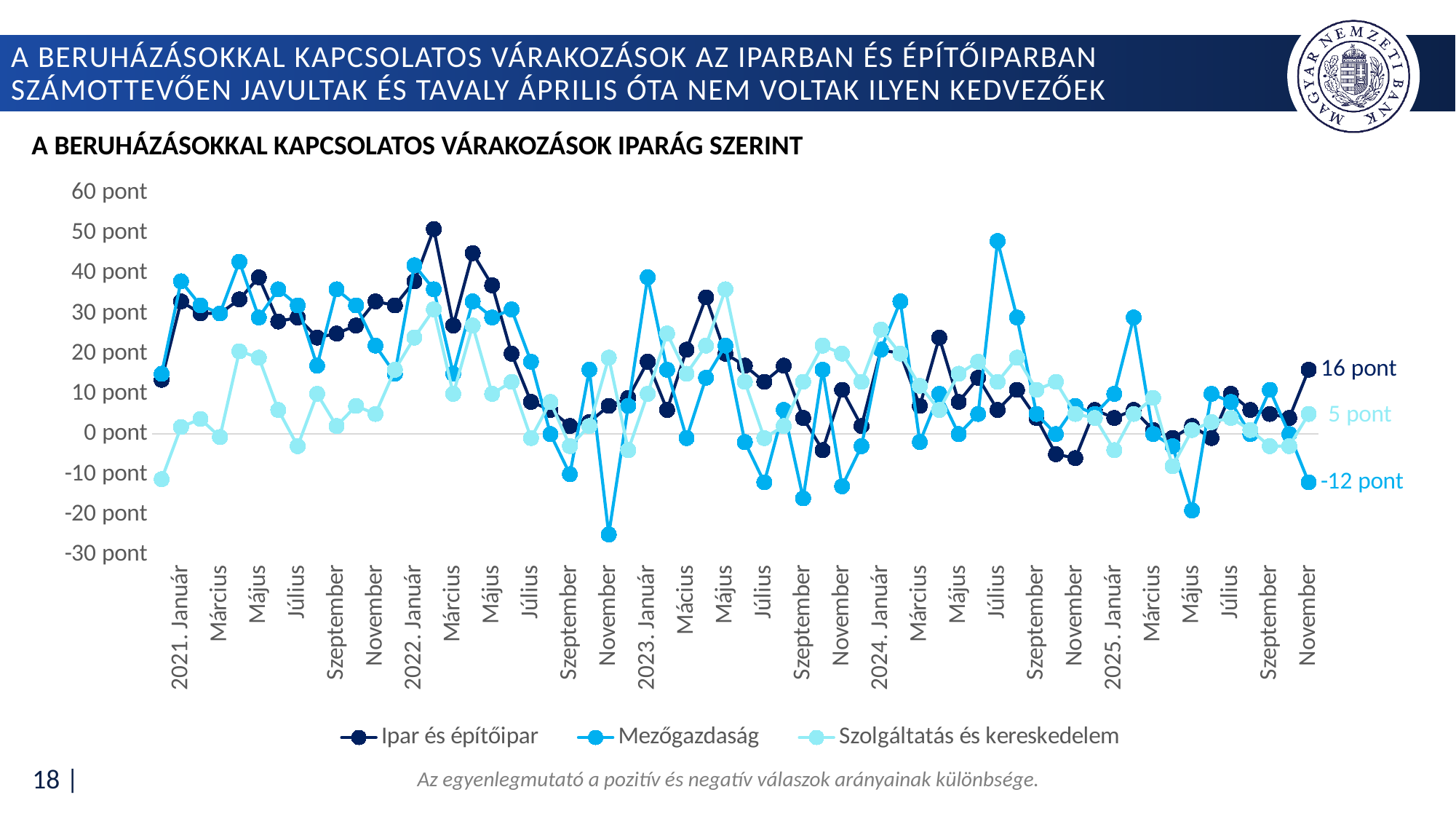
What kind of chart is shown on the slide? Line chart What is the final (November 2025) value shown for the Ipar és építőipar series? 16 pont Which series has the lowest value at the last data point (November 2025)? Mezőgazdaság What is the difference between the final values of Ipar és építőipar and Mezőgazdaság? 28 pont What is the difference between the final values of Ipar és építőipar and Szolgáltatás és kereskedelem? 11 pont What is the final (November 2025) value shown for the Mezőgazdaság series? -12 pont Is the peak value of Mezőgazdaság in July 2024 greater or less than 40 pont? greater How many series does the legend list? 3 What is the final (November 2025) value shown for the Szolgáltatás és kereskedelem series? 5 pont Which series has the highest value at the last data point (November 2025)? Ipar és építőipar At the last data point, is the value for Mezőgazdaság or Szolgáltatás és kereskedelem larger? Szolgáltatás és kereskedelem Is the value for Mezőgazdaság in November 2022 greater or less than -20 pont? less